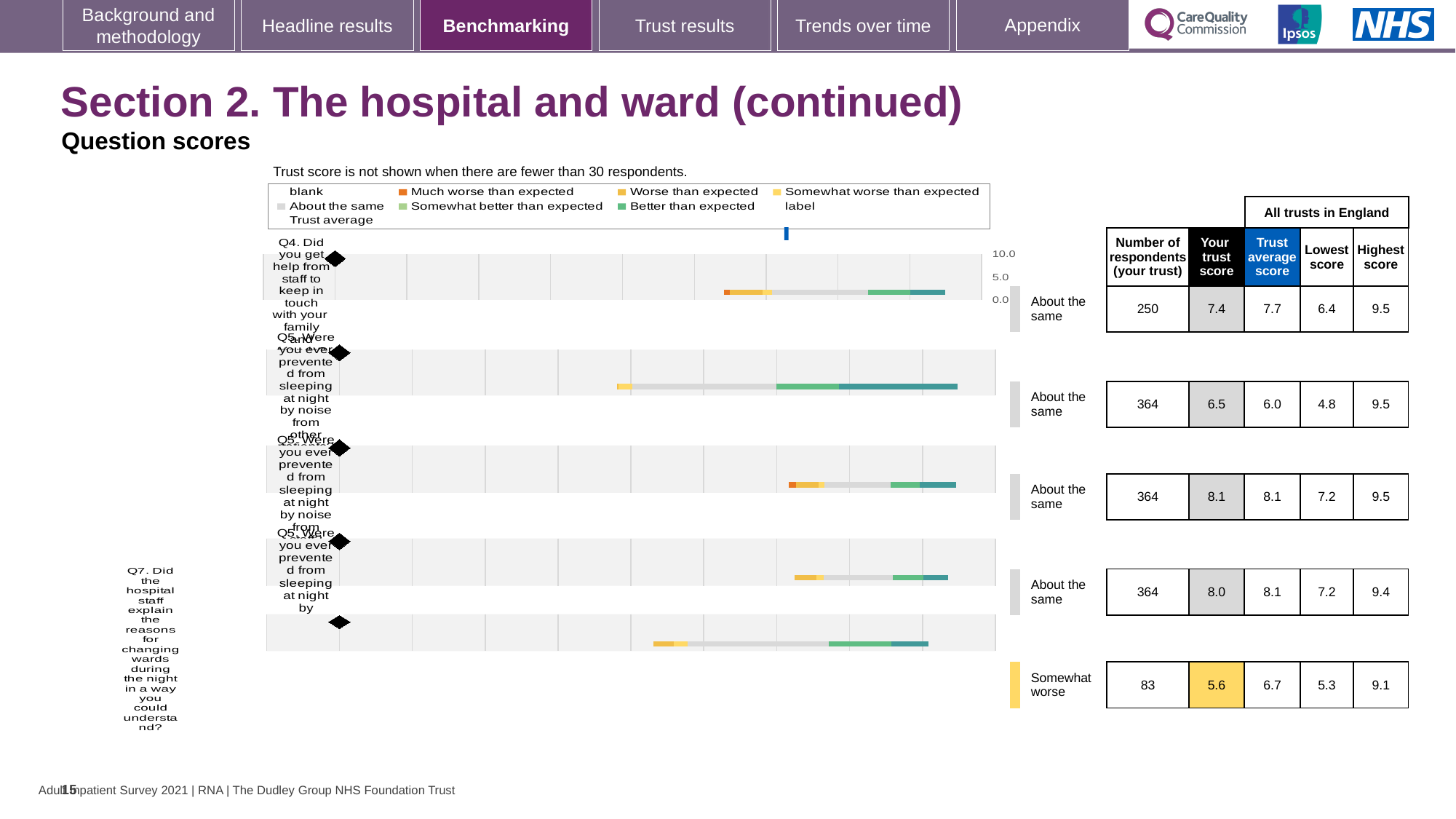
What is the 'Your trust score' for the bottom row of the chart (83 respondents)? 5.6 Which row of the chart is rated 'Somewhat worse' rather than 'About the same'? the bottom row (83 respondents) For the second row of the chart (364 respondents), which is larger: your trust score or the trust average score? your trust score (6.5) What is the 'Highest score' for the second row of the chart (364 respondents, your trust score 6.5)? 9.5 For the bottom row of the chart (83 respondents), what is the difference between the trust average score (6.7) and your trust score (5.6)? 1.1 How many question rows (bars) are plotted in the benchmarking chart? 5 What kind of chart is used to show the question scores on this slide? bar chart Which row of the chart has the highest 'Your trust score'? the third row (8.1) Which row of the chart has the lowest 'Your trust score'? the bottom row (5.6) What is the 'Trust average score' for the top row of the chart (Q4, 250 respondents)? 7.7 What is the 'Your trust score' for the top row of the chart (Q4, 250 respondents)? 7.4 What note is printed above the chart legend about when the trust score is not shown? Trust score is not shown when there are fewer than 30 respondents.